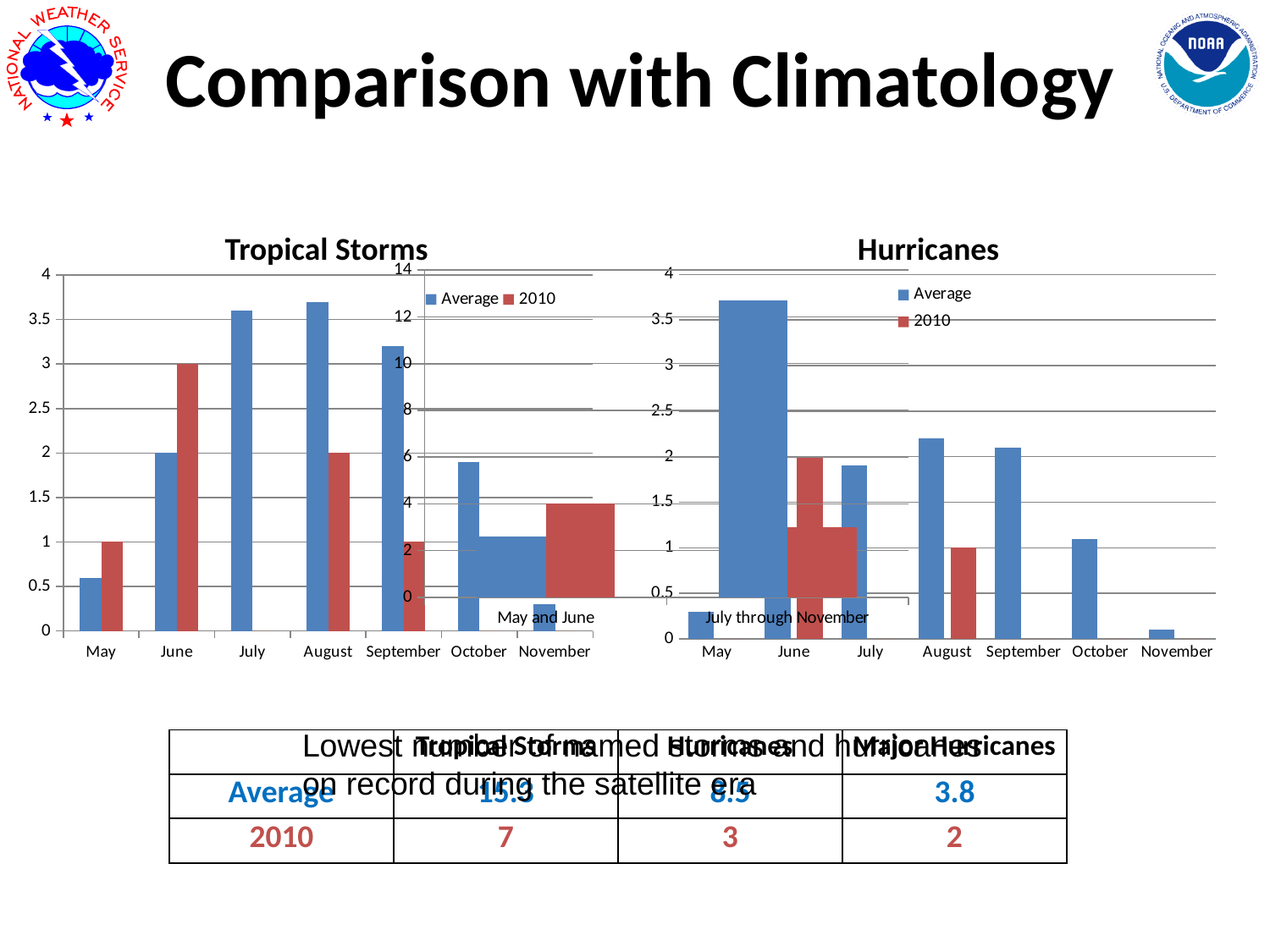
In the Tropical Storms chart, what is the 2010 value for August? 2 How many months are shown on the x axis of the Tropical Storms chart? 7 In the Tropical Storms chart, for June, which is larger: the Average value or the 2010 value? 2010 What kind of chart is the Tropical Storms chart? bar chart In the Tropical Storms chart, which month has the highest 2010 value? June In the Tropical Storms chart, what is the Average value for June? 2 In the Tropical Storms chart, what is the 2010 value for May? 1 In the Hurricanes chart, what is the 2010 value for August? 1 In the Hurricanes chart, is the Average value for August greater or less than 2? greater How many series does the legend of the Tropical Storms chart list? 2 In the Tropical Storms chart, what is the 2010 value for June? 3 In the Tropical Storms chart, is the Average value for July greater or less than 3? greater